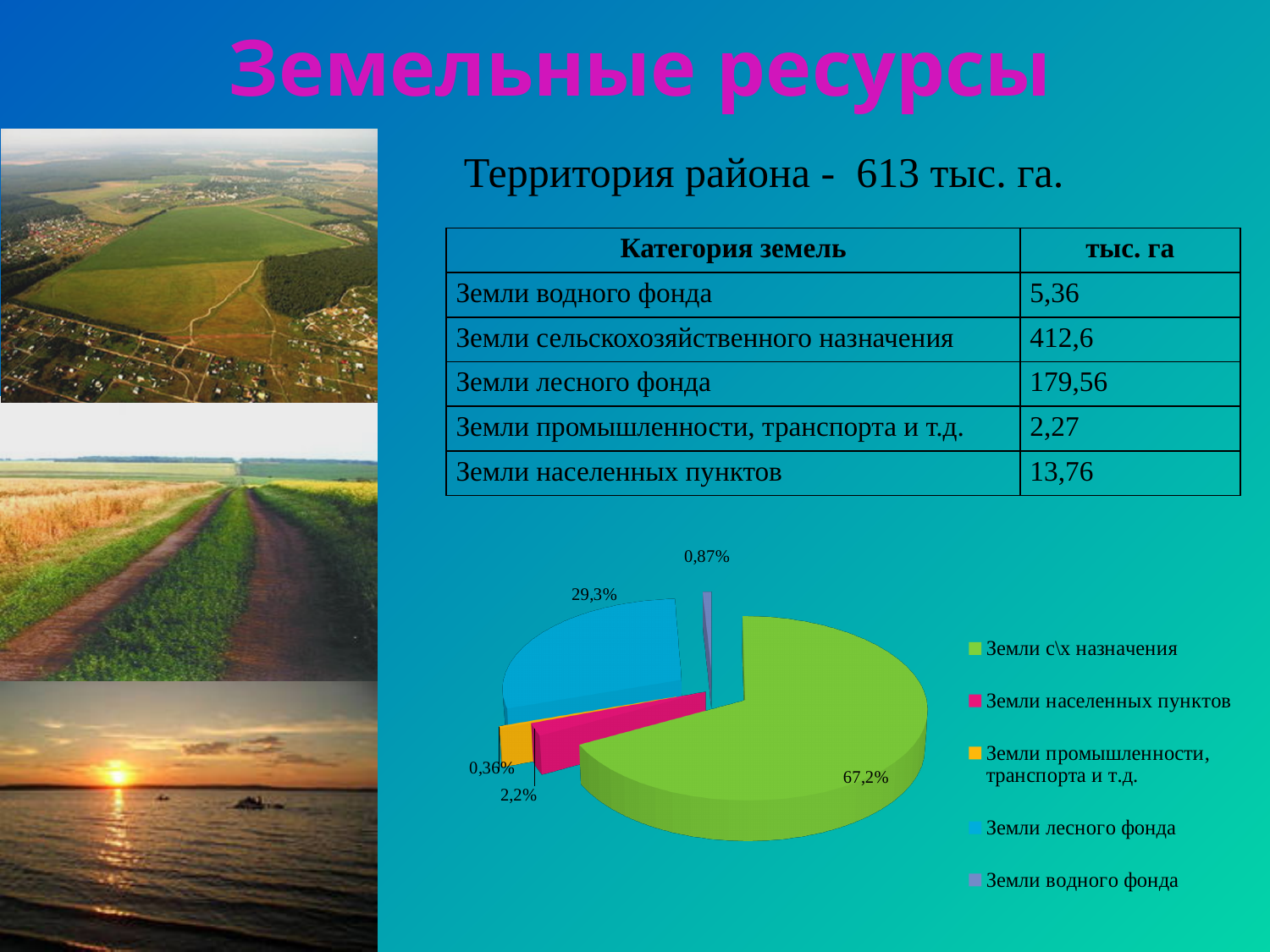
How many slices does the pie chart have? 5 How many entries does the chart legend list? 5 What share of the pie is labelled for Земли с\х назначения? 67,2% What share of the pie is labelled for Земли промышленности, транспорта и т.д.? 0,36% Which slice is larger: Земли лесного фонда or Земли населенных пунктов? Земли лесного фонда What share of the pie is labelled for Земли водного фонда? 0,87% Which category has the smallest slice of the pie? Земли промышленности, транспорта и т.д. What kind of chart is shown on the slide? pie chart What colour is the slice for Земли с\х назначения? green Which category has the largest slice of the pie? Земли с\х назначения